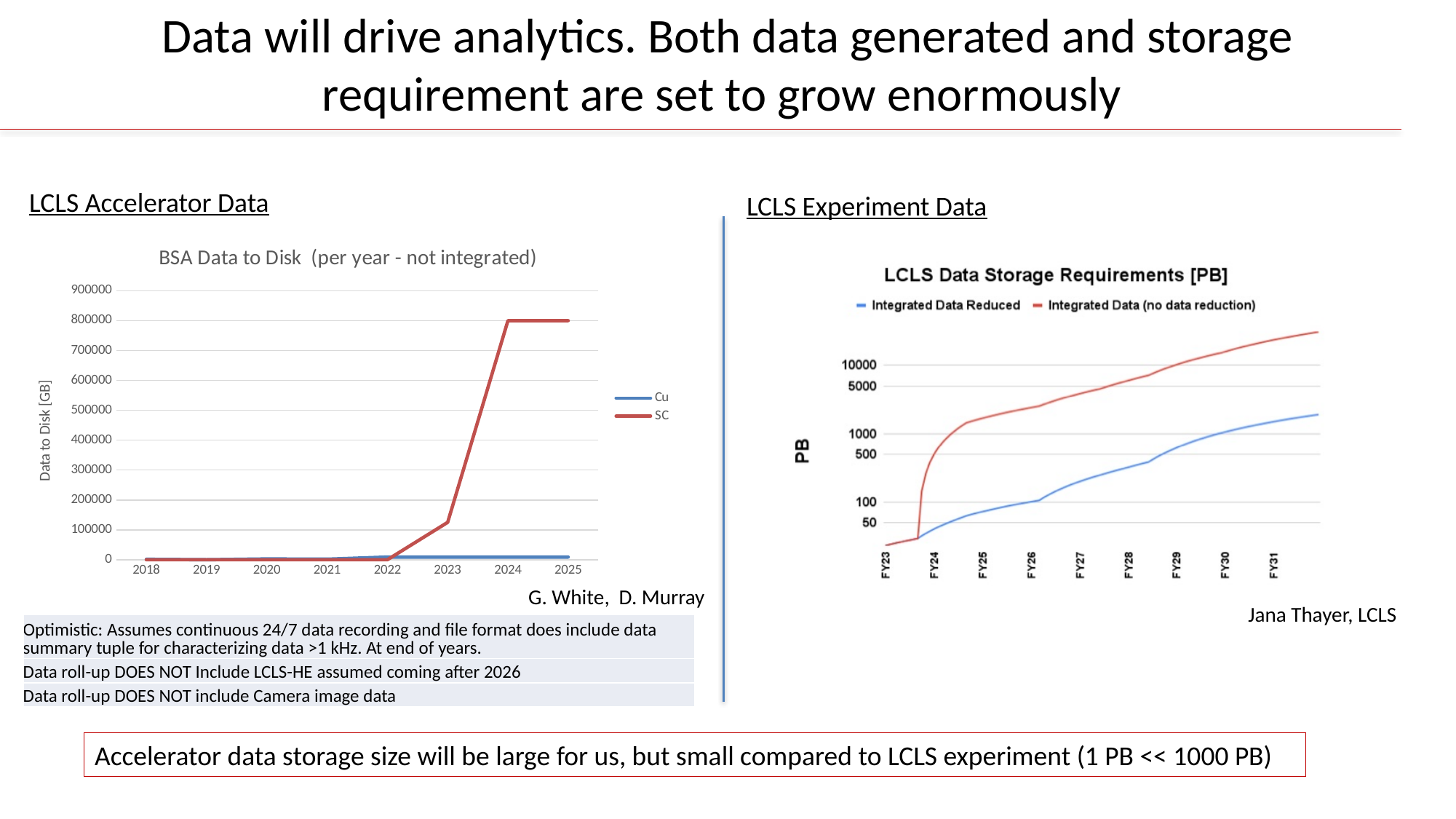
In the 'BSA Data to Disk' chart, in which year does the SC series reach its highest value for the first time? 2024 In the 'BSA Data to Disk' chart, what are the two series named in the legend? Cu and SC How many series does the legend of the 'BSA Data to Disk' chart list? 2 What is the y-axis label of the 'BSA Data to Disk' chart? Data to Disk [GB] How many series does the legend of the 'LCLS Data Storage Requirements [PB]' chart list? 2 In the 'LCLS Data Storage Requirements [PB]' chart, does the Integrated Data Reduced series rise or fall from FY23 to FY31? rise In the 'BSA Data to Disk' chart, is the SC value for 2023 greater or less than 200000? less In the 'BSA Data to Disk' chart, which series is higher in 2025, Cu or SC? SC How many years are shown on the x axis of the 'BSA Data to Disk' chart? 8 In the 'BSA Data to Disk' chart, what is the SC value in 2024? 800000 What type of chart is the 'BSA Data to Disk (per year - not integrated)' chart? line chart In the 'LCLS Data Storage Requirements [PB]' chart, which series is higher in FY31, Integrated Data Reduced or Integrated Data (no data reduction)? Integrated Data (no data reduction)